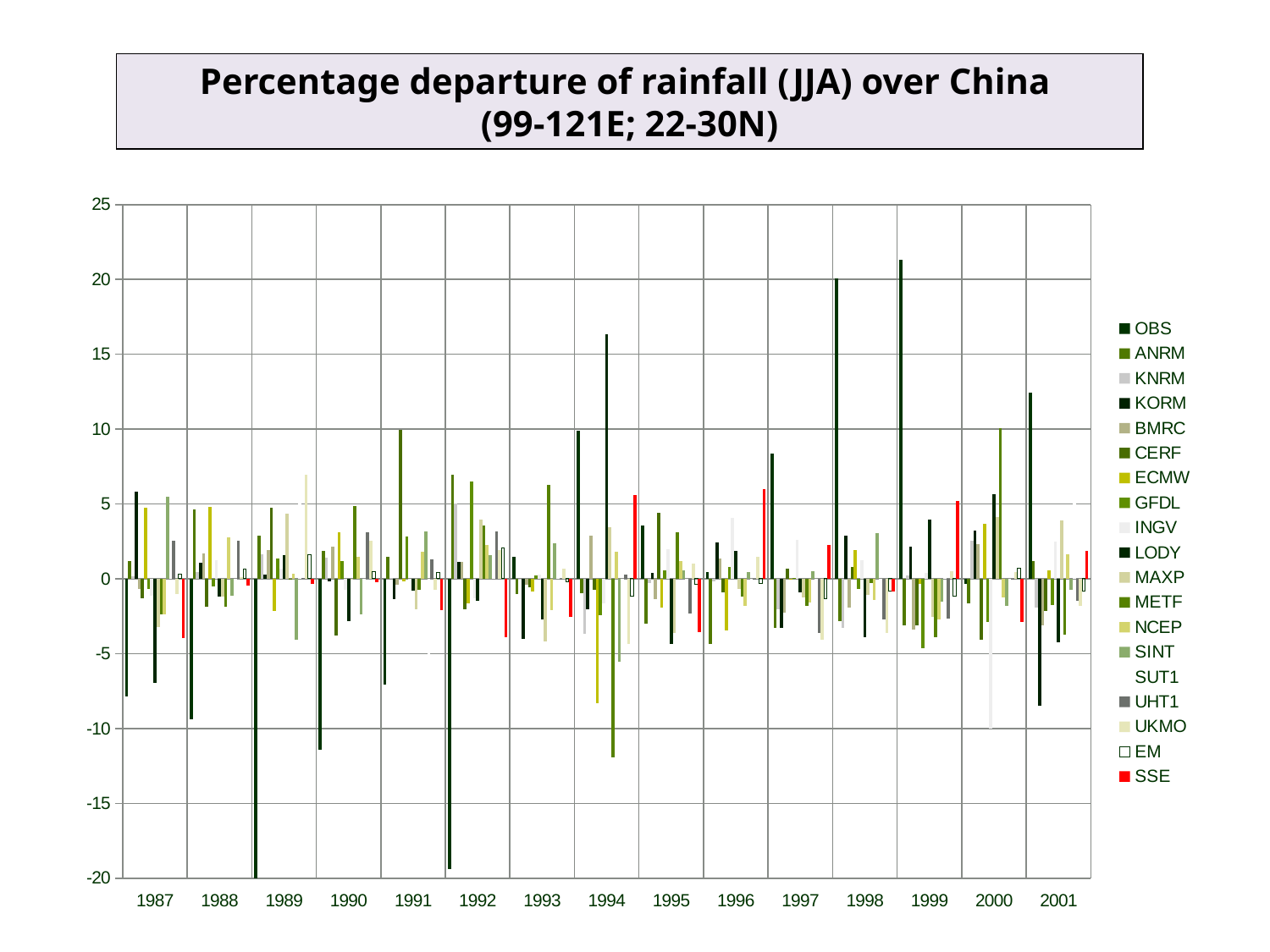
What is the highest value shown on the y axis? 25 How many series does the legend list? 19 Is the OBS value for 1987 greater or less than -5? less Is the OBS value for 1990 greater or less than -10? less What kind of chart is shown on the slide? bar chart Is the OBS value for 1992 greater or less than -15? less What is the title of the chart? Percentage departure of rainfall (JJA) over China (99-121E; 22-30N) Which series is drawn in red in the legend? SSE How many years are shown along the x axis of the chart? 15